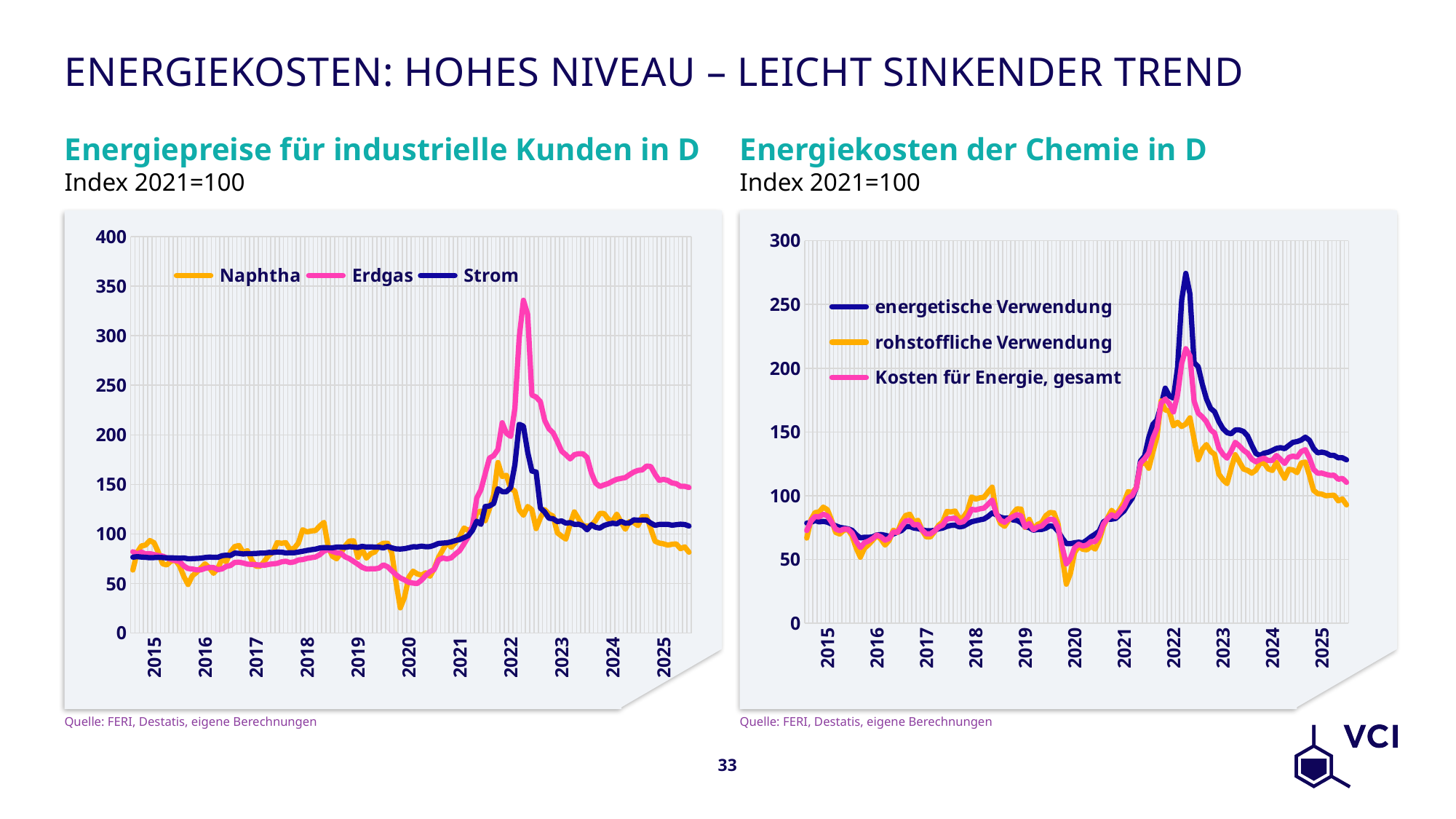
In the right chart 'Energiekosten der Chemie in D', do the values of Kosten für Energie, gesamt rise or fall from the 2022 peak to 2025? fall In the left chart 'Energiepreise für industrielle Kunden in D', which series reaches the highest peak in 2022? Erdgas What kind of chart is the left chart, 'Energiepreise für industrielle Kunden in D'? line chart What kind of chart is the right chart, 'Energiekosten der Chemie in D'? line chart In the left chart 'Energiepreise für industrielle Kunden in D', is the 2022 peak value of Erdgas greater or less than 300? greater In the left chart 'Energiepreise für industrielle Kunden in D', is the 2022 peak value of Strom greater or less than 250? less How many series does the legend of the right chart 'Energiekosten der Chemie in D' list? 3 How many series does the legend of the left chart 'Energiepreise für industrielle Kunden in D' list? 3 Which series are listed in the legend of the left chart 'Energiepreise für industrielle Kunden in D'? Naphtha, Erdgas, Strom In the left chart 'Energiepreise für industrielle Kunden in D', is the lowest value of Naphtha around 2020 greater or less than 50? less In the right chart 'Energiekosten der Chemie in D', which series reaches the highest peak in 2022? energetische Verwendung